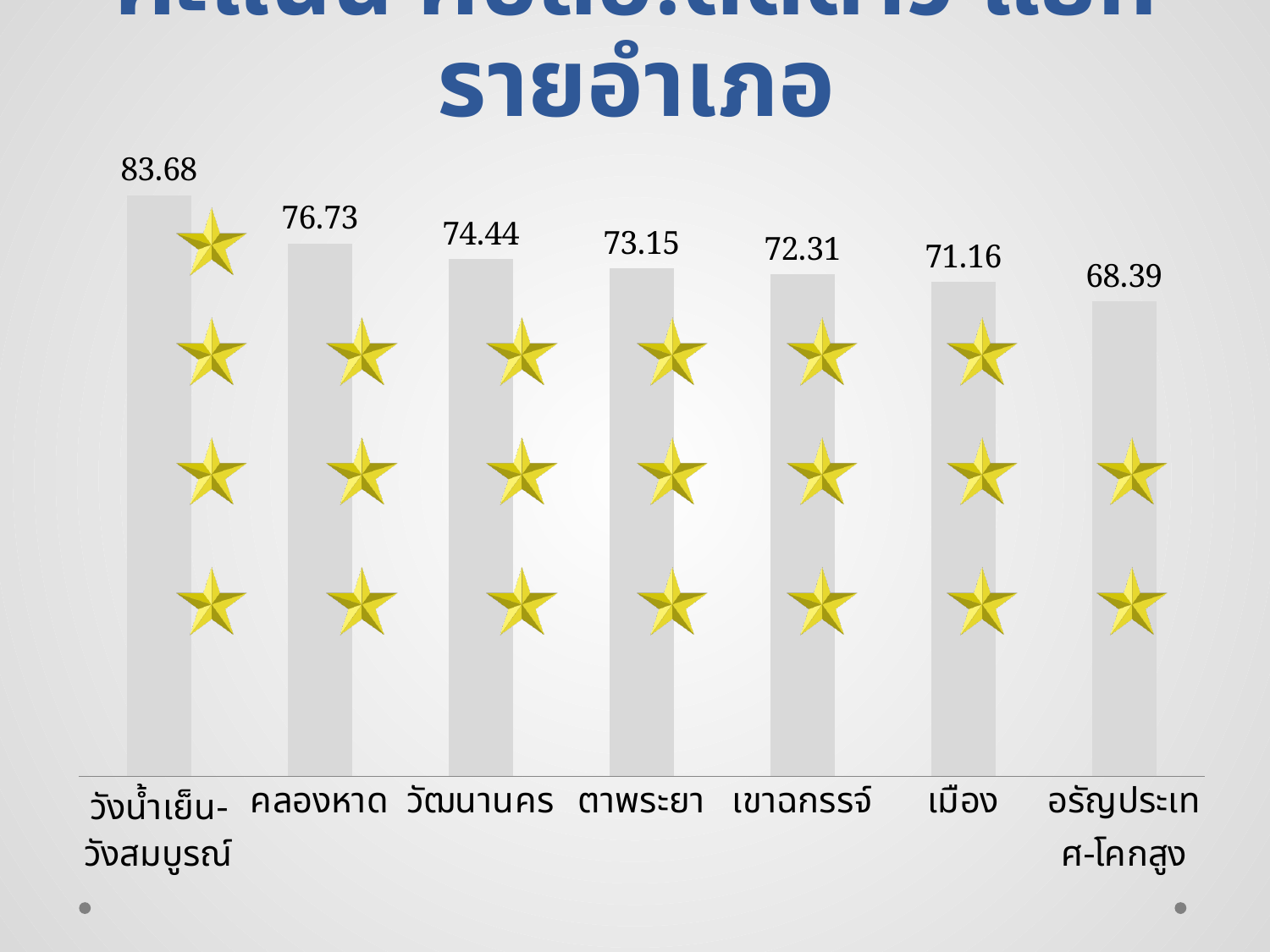
Which is larger, the value for เขาฉกรรจ์ or the value for เมือง? เขาฉกรรจ์ What kind of chart is shown on the slide? bar chart Which category has the lowest value? อรัญประเทศ-โคกสูง Do the values rise or fall from left to right across the categories? fall How many categories are shown in the chart? 7 What is the difference between the values for วังน้ำเย็น-วังสมบูรณ์ and อรัญประเทศ-โคกสูง? 15.29 What is the value for อรัญประเทศ-โคกสูง? 68.39 What is the difference between the values for คลองหาด and วัฒนานคร? 2.29 Which category has the highest value? วังน้ำเย็น-วังสมบูรณ์ What is the value for คลองหาด? 76.73 What is the value for เมือง? 71.16 What is the value for ตาพระยา? 73.15